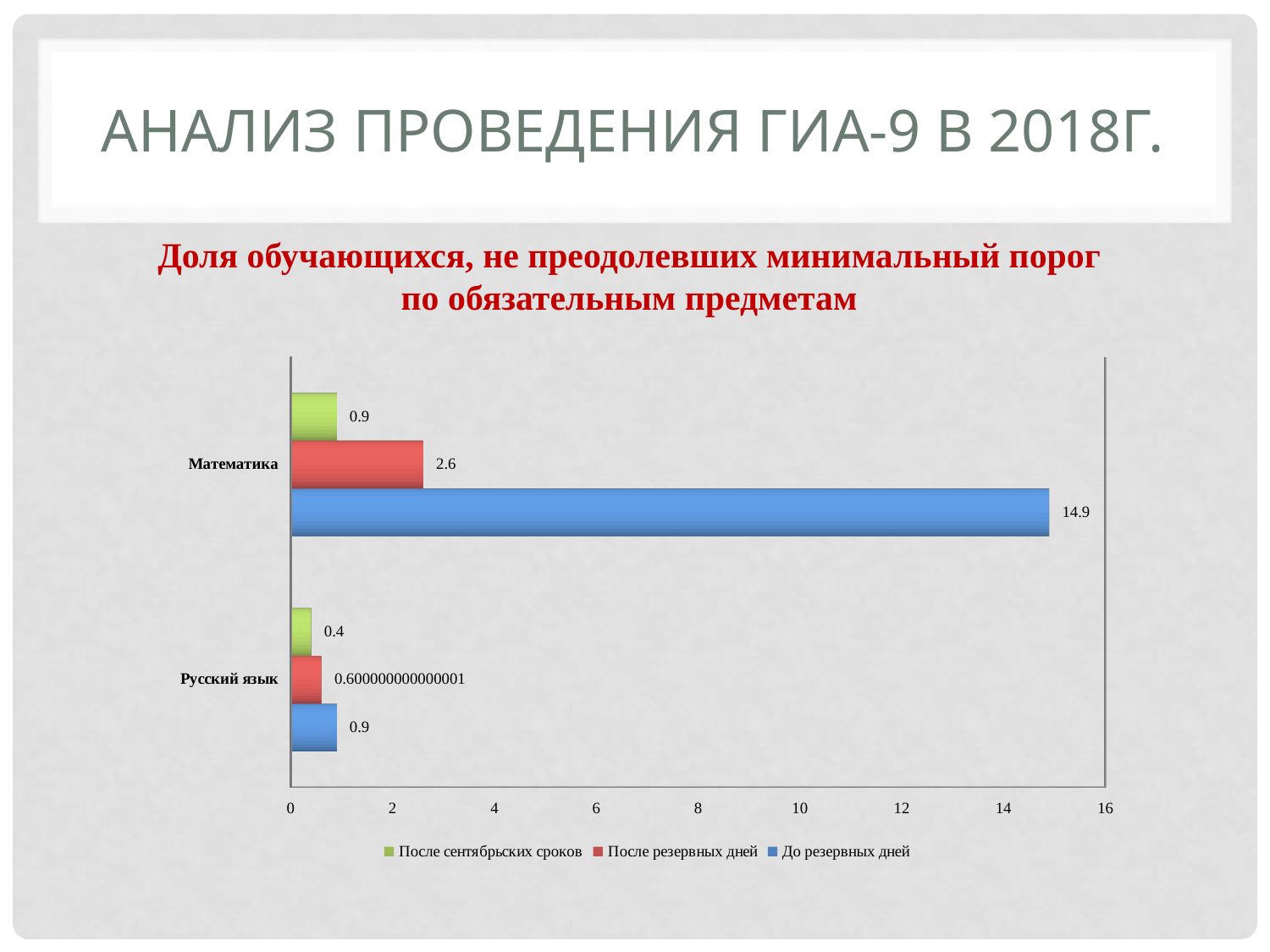
How many series does the legend list? 3 What is the data label shown for Русский язык in the series После резервных дней? 0.600000000000001 Which is larger: the После резервных дней value for Математика or the До резервных дней value for Русский язык? После резервных дней value for Математика What kind of chart is shown on the slide? Bar chart What is the value for Русский язык in the series После сентябрьских сроков? 0.4 How many categories are shown on the chart? 2 Which category has the lowest value in the series После сентябрьских сроков? Русский язык What is the difference between the До резервных дней values for Математика and Русский язык? 14 Which category has the highest value in the series До резервных дней? Математика What is the value for Русский язык in the series До резервных дней? 0.9 What is the value for Математика in the series После резервных дней? 2.6 What is the value for Математика in the series До резервных дней? 14.9